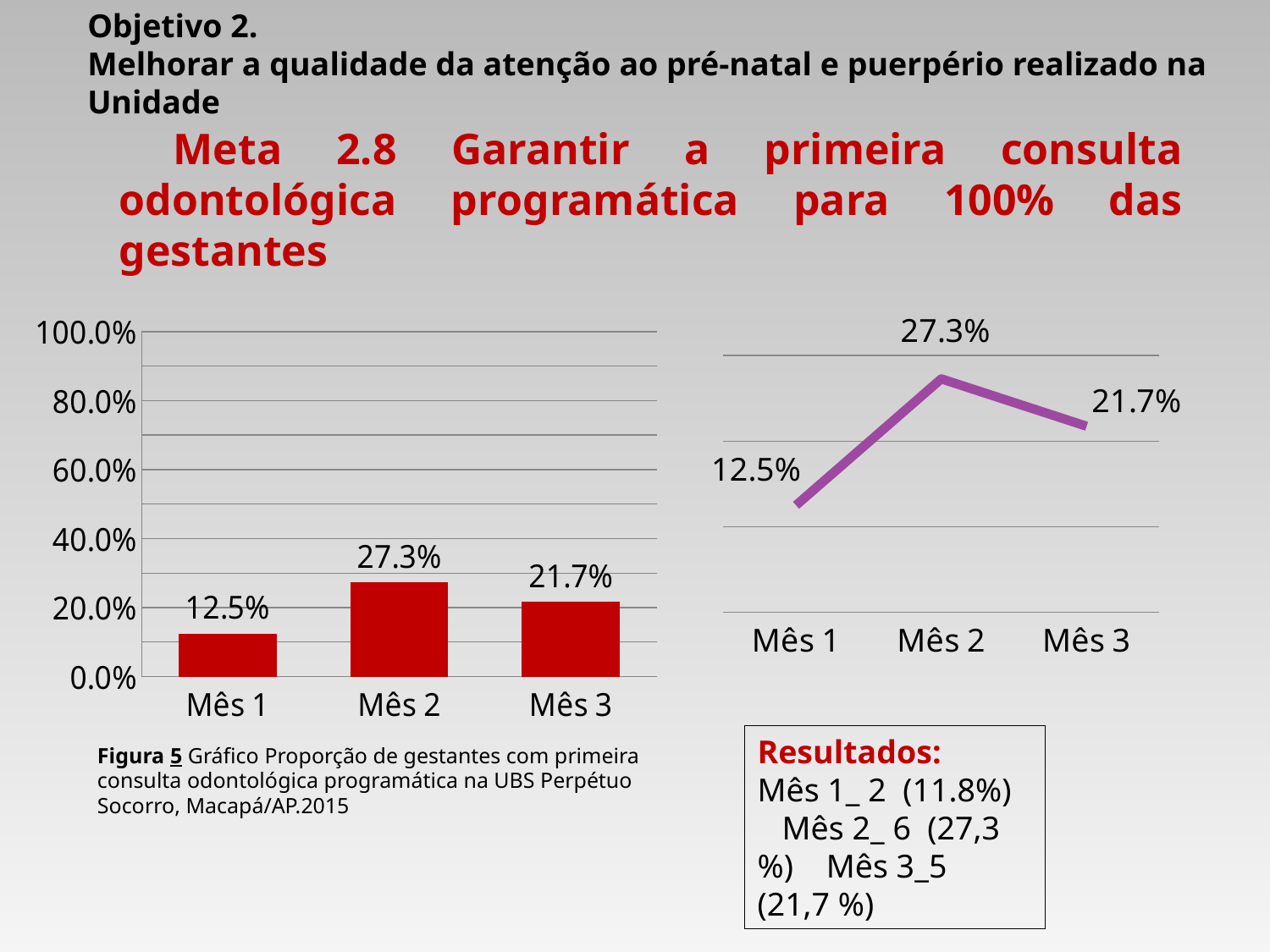
How many months are shown on the x axis of the bar chart on the left? 3 In the bar chart on the left, which is larger, the value for Mês 3 or the value for Mês 1? Mês 3 In the line chart on the right, does the value rise or fall from Mês 2 to Mês 3? fall In the line chart on the right, which month has the lowest value? Mês 1 In the bar chart on the left, what is the difference between the values for Mês 2 and Mês 1? 14.8% In the bar chart on the left, is the value for Mês 2 greater or less than 40.0%? less In the line chart on the right, what is the value for Mês 3? 21.7% In the bar chart on the left, what is the value for Mês 2? 27.3% What kind of chart is the chart on the right side of the slide? line chart In the line chart on the right, what is the difference between the values for Mês 2 and Mês 3? 5.6% In the bar chart on the left, what is the value for Mês 1? 12.5% In the bar chart on the left, which month has the highest value? Mês 2